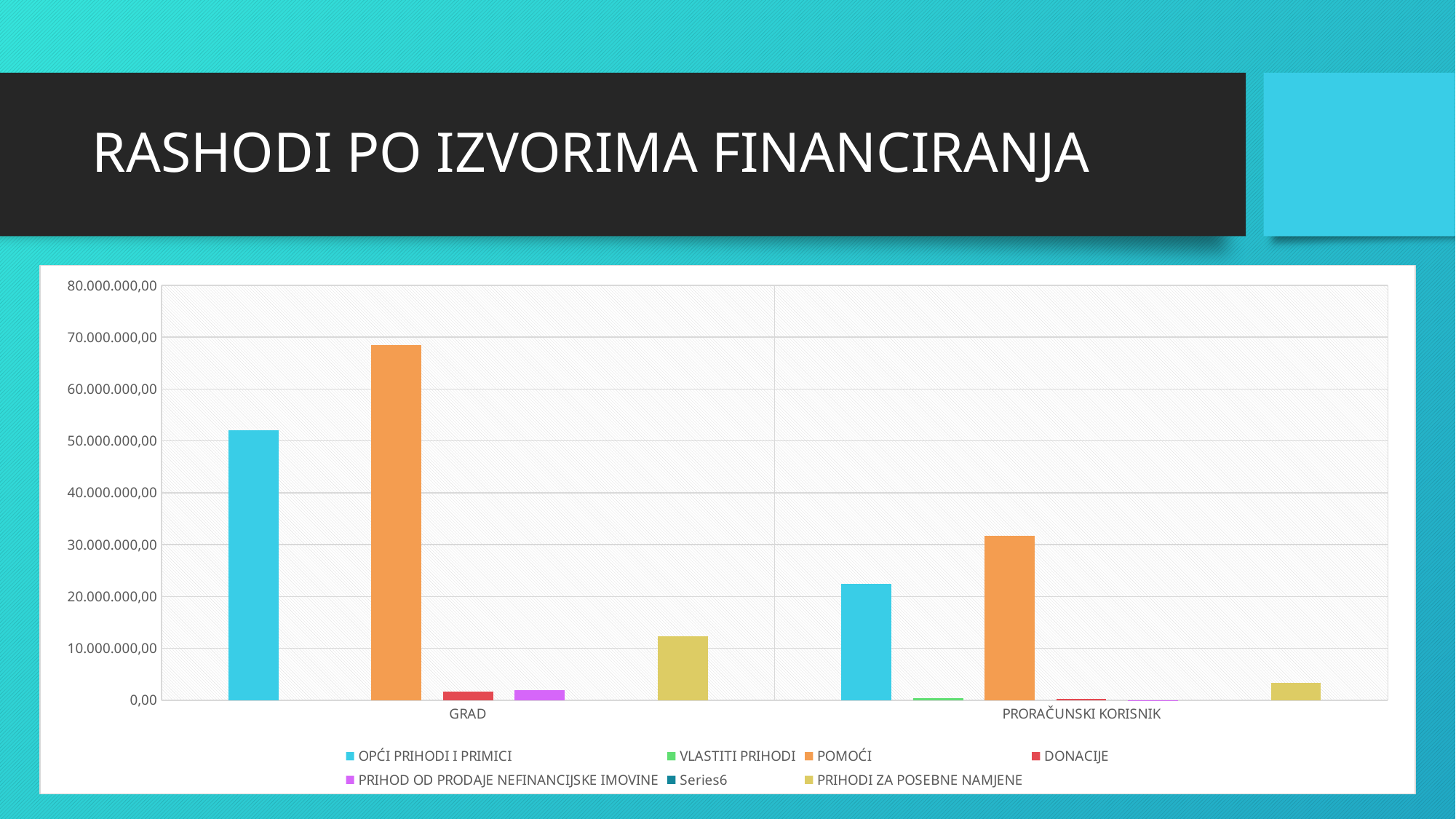
How many categories are shown on the x axis? 2 What kind of chart is shown on the slide? Bar chart Is the value of POMOĆI for PRORAČUNSKI KORISNIK greater or less than 30.000.000,00? greater Is the value of PRIHODI ZA POSEBNE NAMJENE for GRAD greater or less than 10.000.000,00? greater Which is larger: OPĆI PRIHODI I PRIMICI for GRAD or OPĆI PRIHODI I PRIMICI for PRORAČUNSKI KORISNIK? GRAD How many series does the legend list? 7 Is the value of OPĆI PRIHODI I PRIMICI for GRAD greater or less than 50.000.000,00? greater What is the title of the slide containing the chart? RASHODI PO IZVORIMA FINANCIRANJA Which series has the highest bar for GRAD? POMOĆI Which series has the highest bar for PRORAČUNSKI KORISNIK? POMOĆI